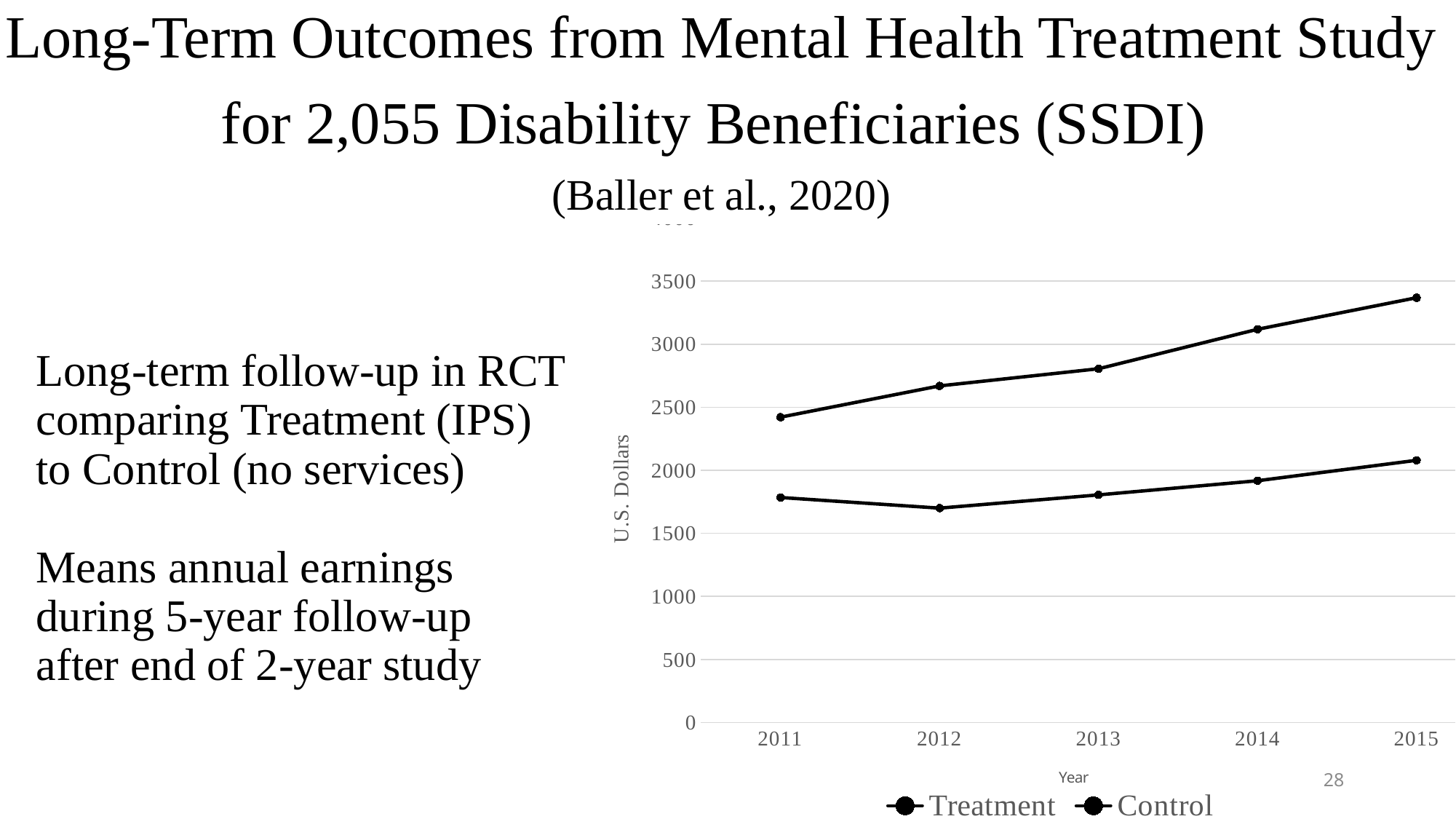
In which year does the upper line reach its highest value? 2015 Is the value of the upper line in 2015 greater or less than 3000? greater Is the value of the upper line in 2011 greater or less than 2000? greater How many years are plotted along the x axis of the chart? 5 What is the label on the chart's vertical axis? U.S. Dollars What kind of chart is shown on the slide? line chart Is the value of the lower line in 2012 greater or less than 2000? less In which year does the lower line reach its lowest value? 2012 Does the upper line rise or fall from 2011 to 2015? rise What are the two series named in the chart's legend? Treatment and Control How many series does the chart's legend list? 2